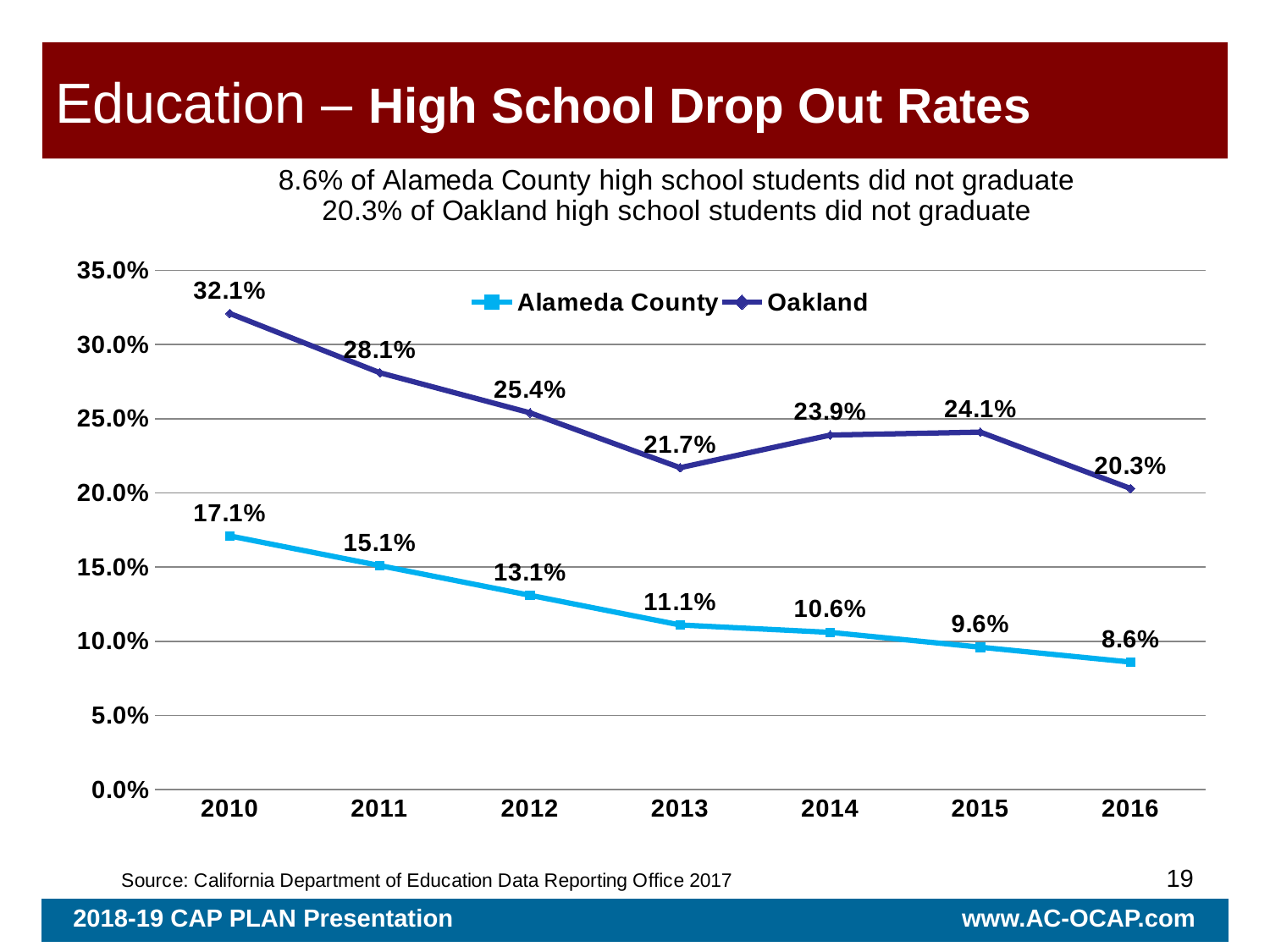
What is the overall trend of the Alameda County drop out rate from 2010 to 2016? Falling Was the Oakland drop out rate in 2012 greater or less than 25.0%? greater By how much did the Alameda County drop out rate fall from 2010 to 2016? 8.5% In which year was the Oakland drop out rate highest? 2010 What was the Alameda County drop out rate in 2014? 10.6% How many years are shown on the x axis? 7 How many series does the legend list? 2 What is the difference between the Oakland and Alameda County drop out rates in 2016? 11.7% Which was higher in 2015, the Oakland rate or the Alameda County rate? Oakland In which year was the Alameda County drop out rate lowest? 2016 What kind of chart is shown on the slide? Line chart What was the Oakland high school drop out rate in 2013? 21.7%